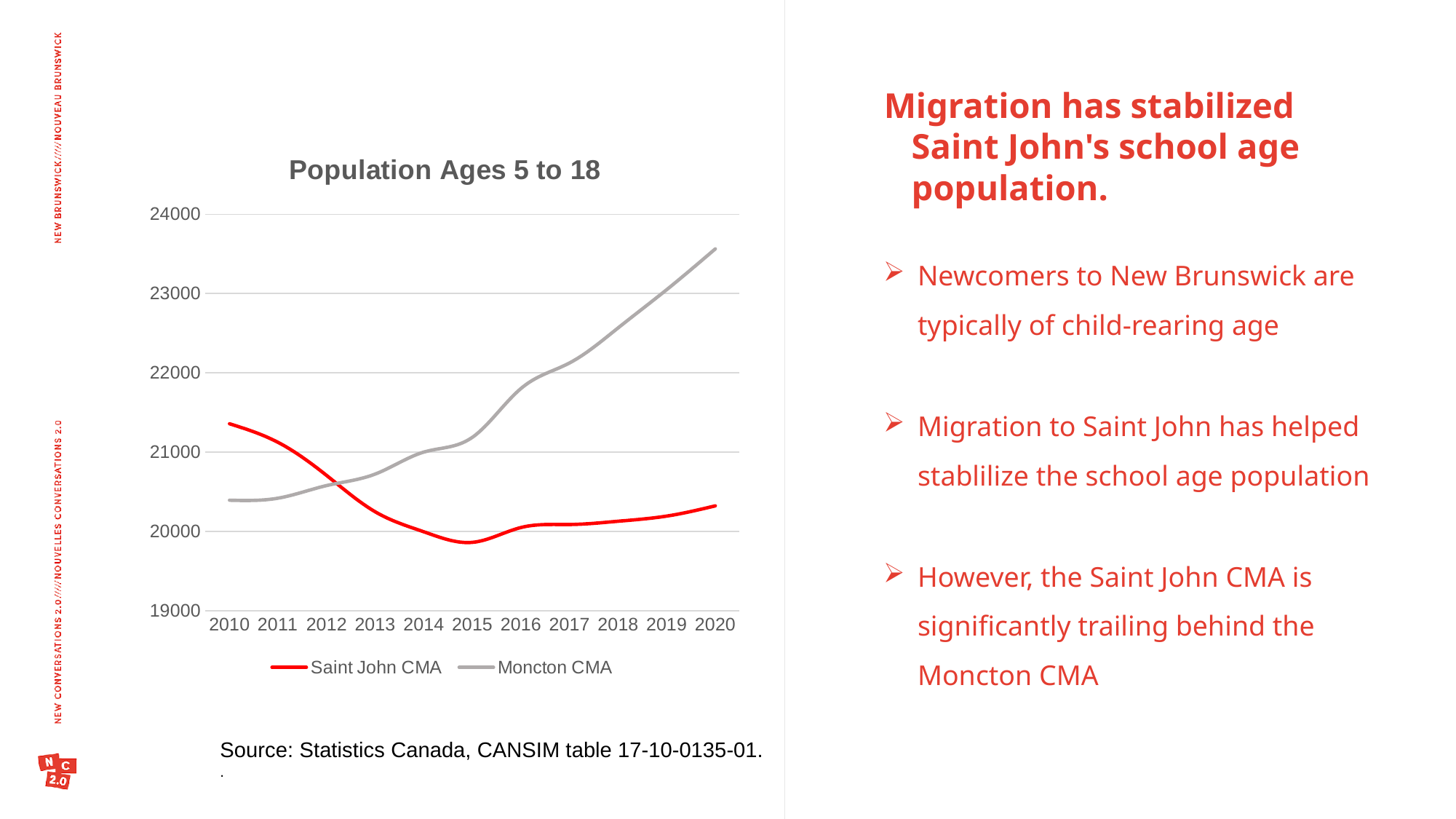
In which year is the Moncton CMA value highest? 2020 In which year is the Saint John CMA value lowest? 2015 Is the Saint John CMA value for 2015 greater or less than 20000? less Is the Moncton CMA value for 2020 greater or less than 23000? greater Does the Saint John CMA line rise or fall from 2010 to 2015? fall What kind of chart is shown on the slide? line chart In 2020, which series has the larger value, Saint John CMA or Moncton CMA? Moncton CMA Does the Moncton CMA line rise or fall from 2010 to 2020? rise How many series does the legend list? 2 Which series is drawn in red? Saint John CMA How many years are plotted along the x axis? 11 What is the title of the chart? Population Ages 5 to 18